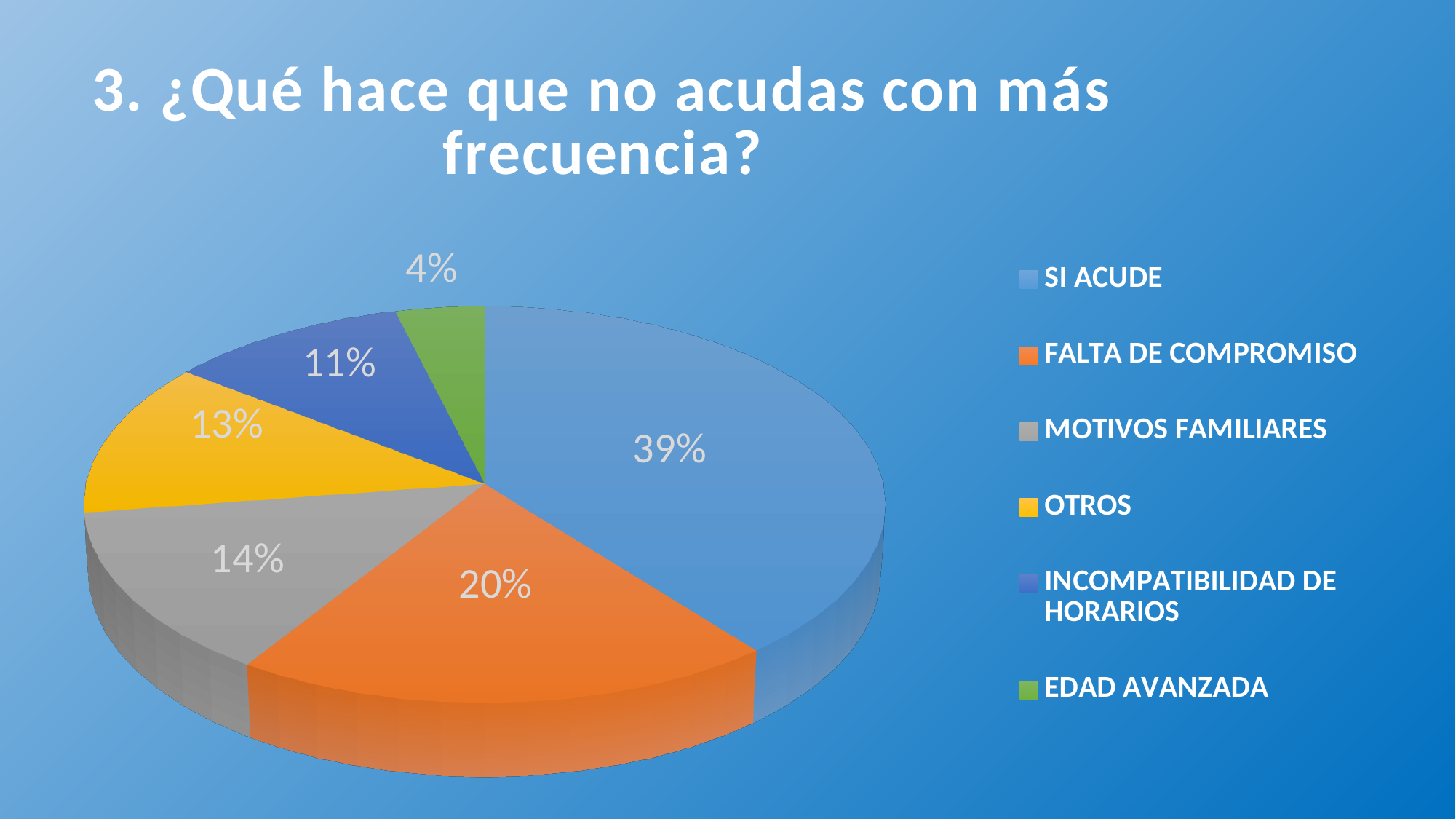
What percentage does the SI ACUDE slice represent? 39% What percentage does the MOTIVOS FAMILIARES slice represent? 14% What kind of chart is shown on the slide? pie chart What percentage does the FALTA DE COMPROMISO slice represent? 20% Which category has the smallest share of the pie? EDAD AVANZADA How many categories does the legend list? 6 What percentage does the INCOMPATIBILIDAD DE HORARIOS slice represent? 11% What percentage does the OTROS slice represent? 13% What is the difference in percentage points between SI ACUDE and FALTA DE COMPROMISO? 19 What percentage does the EDAD AVANZADA slice represent? 4% Which category has the largest share of the pie? SI ACUDE Which is larger, the share for OTROS or the share for INCOMPATIBILIDAD DE HORARIOS? OTROS